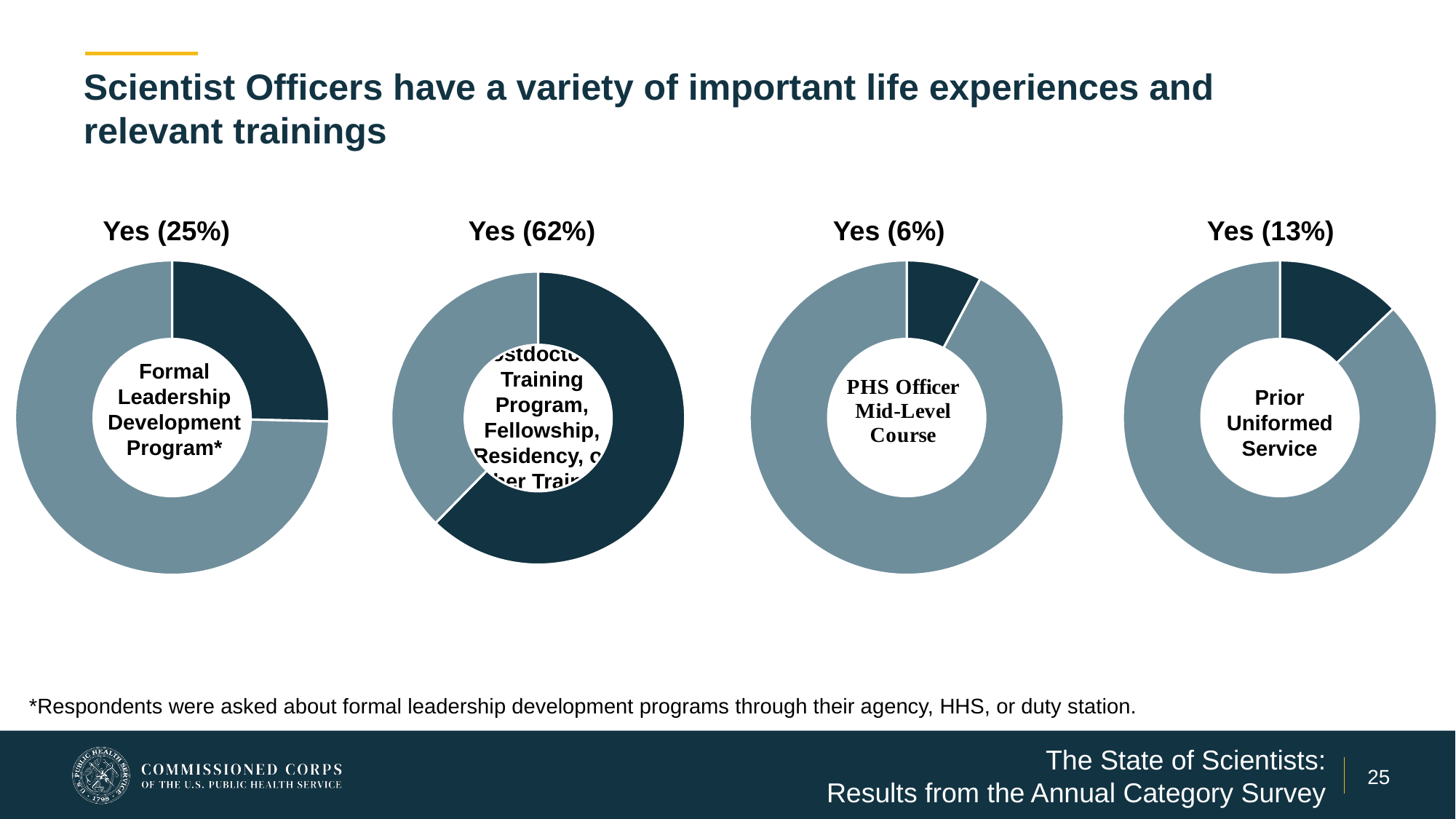
What colour is used for the Yes segment in the donut charts? Dark navy blue In the Prior Uniformed Service chart, what share of the donut is the No portion? 87% In the second donut chart from the left, what percentage answered Yes? 62% Which of the four donut charts has the lowest Yes percentage? PHS Officer Mid-Level Course (6%) Which of the four donut charts has the highest Yes percentage? The second chart from the left (Yes 62%) What type of chart is used to show the Formal Leadership Development Program results? Donut (pie) chart Which is larger: the Yes percentage for Prior Uniformed Service or for the PHS Officer Mid-Level Course? Prior Uniformed Service What percentage of Scientist Officers answered Yes to having participated in a Formal Leadership Development Program? 25% How many donut charts are shown on the slide? 4 What percentage of respondents reported Prior Uniformed Service? 13% What is the difference between the Yes percentage for Formal Leadership Development Program and the Yes percentage for Prior Uniformed Service? 12% In the PHS Officer Mid-Level Course chart, what share of respondents answered Yes? 6%